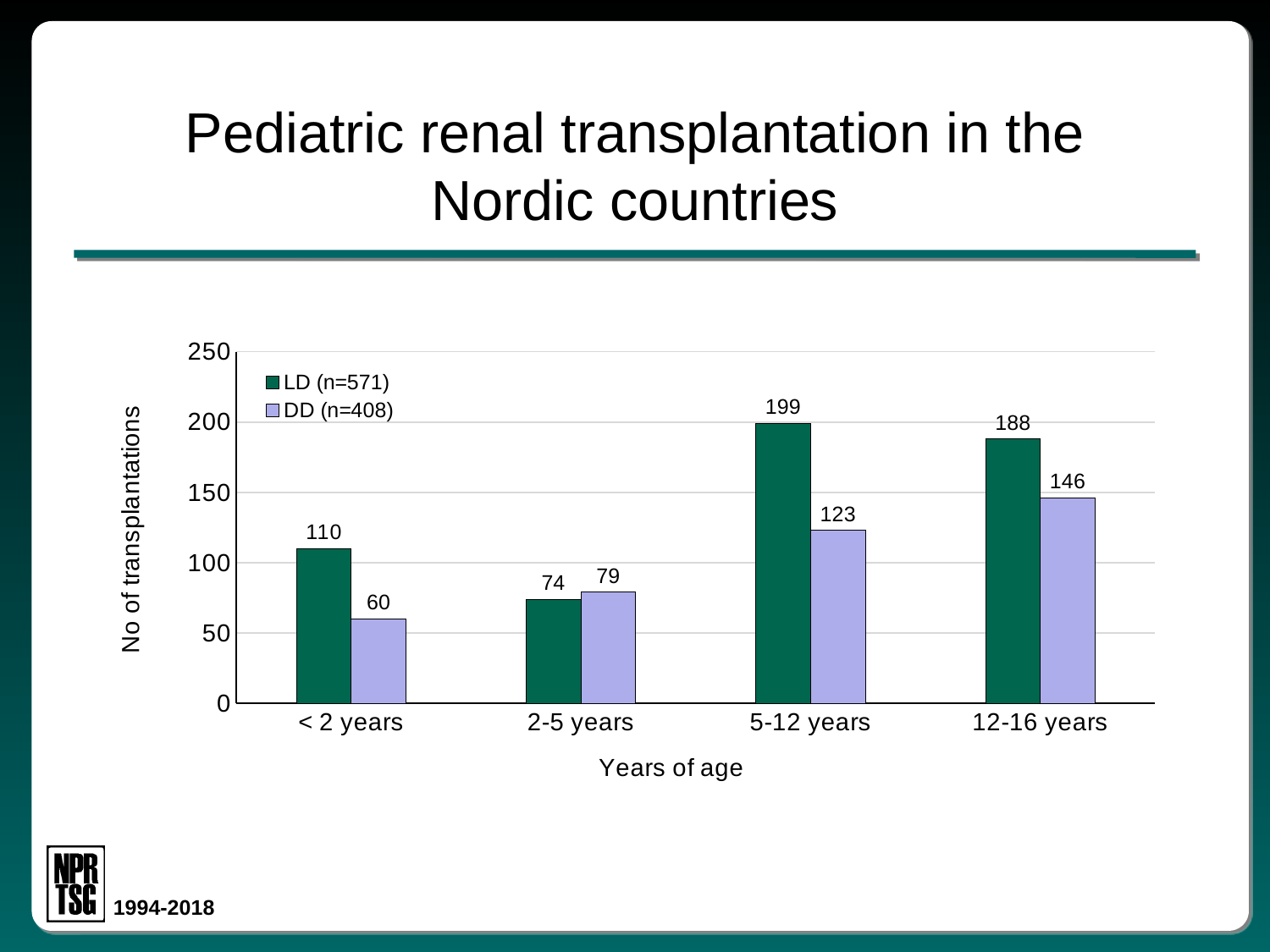
How many series does the legend list? 2 Which age group has the highest number of LD transplantations? 5-12 years Which age group has the lowest number of DD transplantations? < 2 years What is the label of the y axis? No of transplantations What is the number of DD transplantations for the 12-16 years age group? 146 What kind of chart is shown on the slide? Bar chart How many age groups are shown on the x axis? 4 In the 2-5 years age group, which series has the larger value, LD or DD? DD What is the number of LD transplantations for the < 2 years age group? 110 What is the number of DD transplantations for the 2-5 years age group? 79 What is the difference between LD and DD transplantations in the 5-12 years age group? 76 Is the value for LD in the 12-16 years age group greater or less than 150? greater